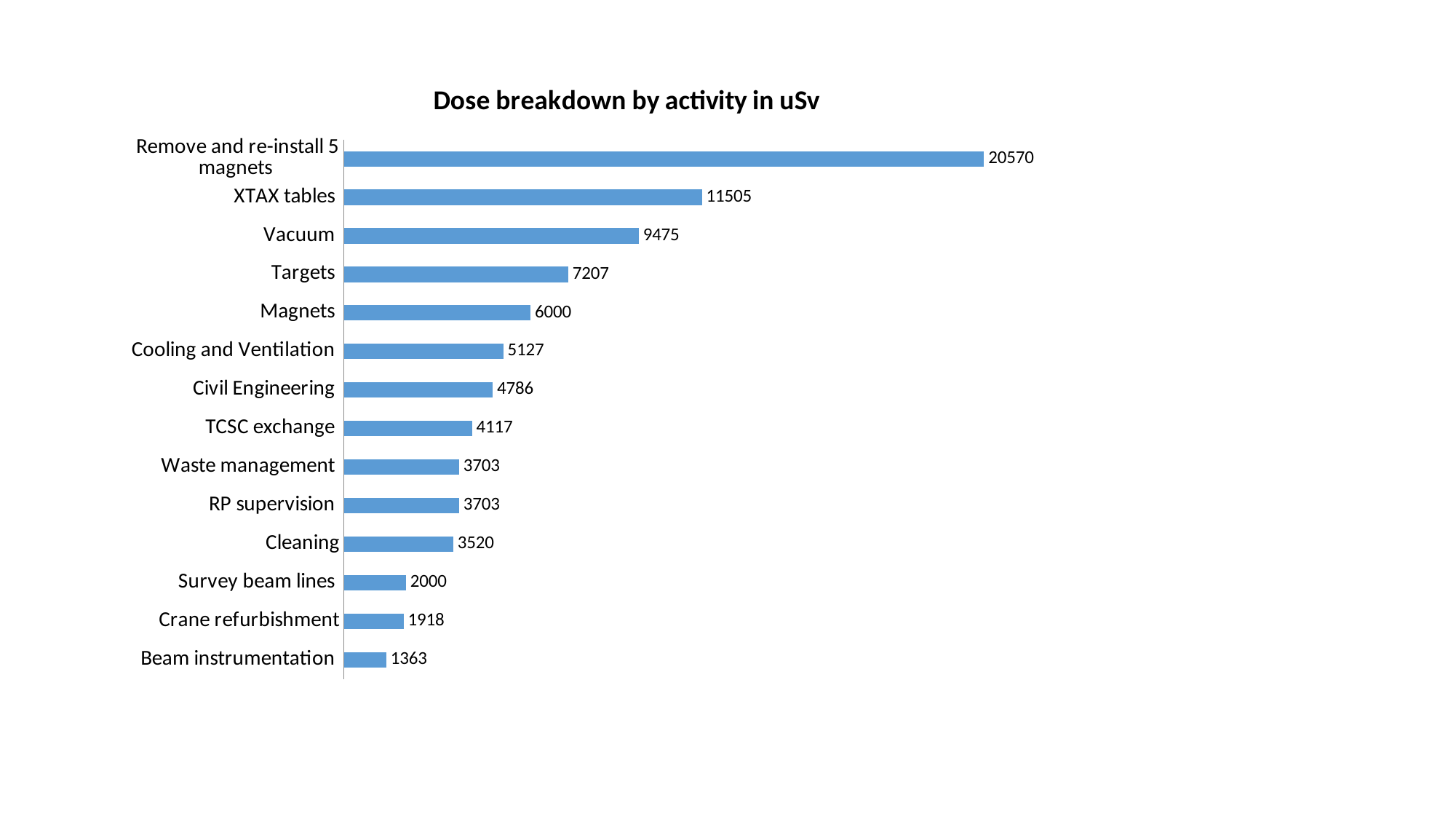
What is the dose for Cooling and Ventilation? 5127 Which has a larger dose, Survey beam lines or Cleaning? Cleaning What kind of chart is this? Bar chart Which activity has the highest dose? Remove and re-install 5 magnets What is the dose for XTAX tables? 11505 Which has a larger dose, Civil Engineering or TCSC exchange? Civil Engineering How many activities are shown in the chart? 14 What is the difference between the dose for Remove and re-install 5 magnets and the dose for XTAX tables? 9065 What is the dose for Crane refurbishment? 1918 What is the difference between the dose for Vacuum and the dose for Targets? 2268 Which activity has the lowest dose? Beam instrumentation What is the title of the chart? Dose breakdown by activity in uSv